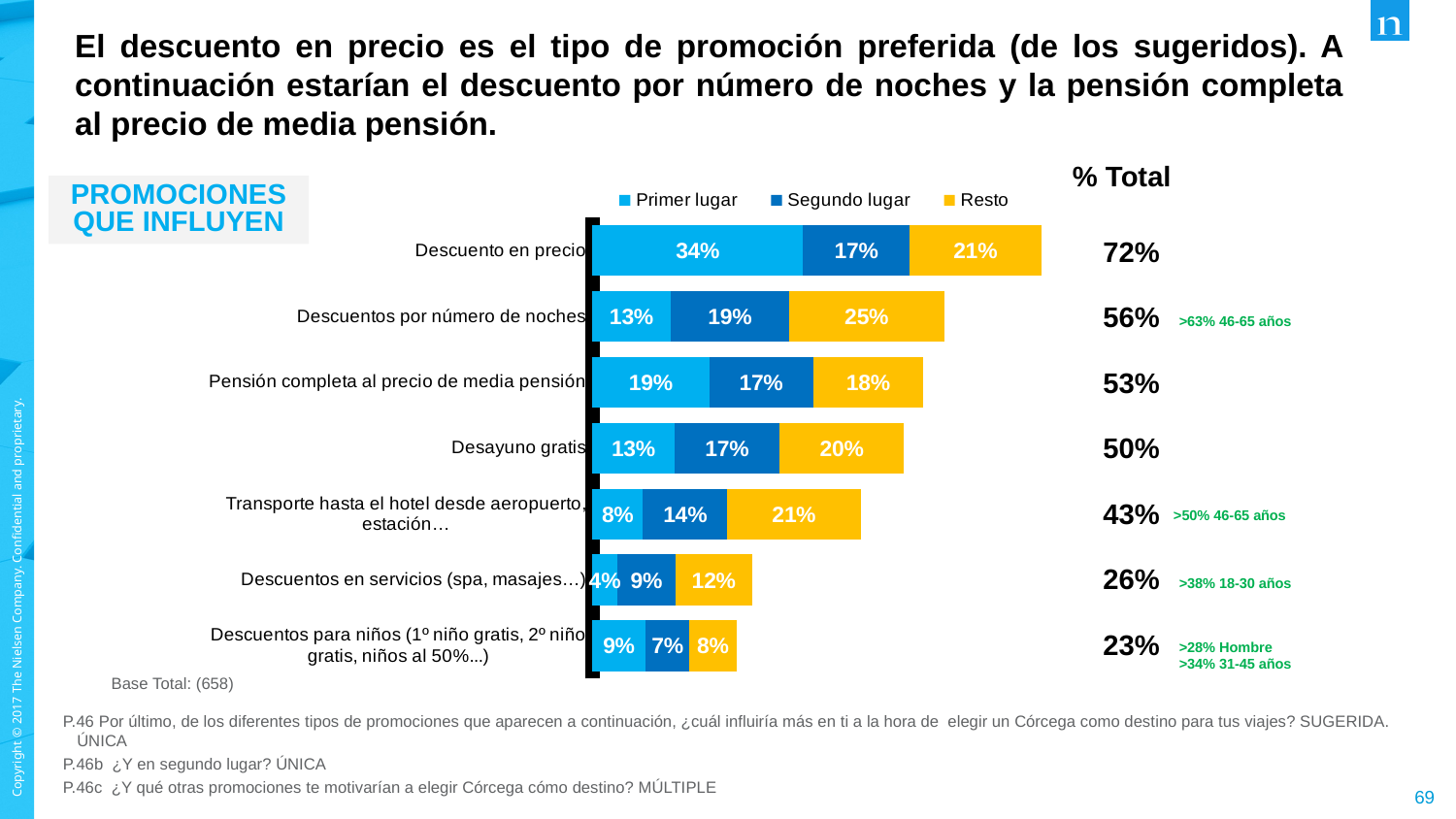
Which has the larger 'Segundo lugar' value: 'Descuentos por número de noches' or 'Desayuno gratis'? Descuentos por número de noches What are the three legend entries of the chart? Primer lugar, Segundo lugar, Resto What is the total of the stacked bar for 'Desayuno gratis'? 50% Which category has the lowest '% Total'? Descuentos para niños (1º niño gratis, 2º niño gratis, niños al 50%...) What is the 'Resto' value for 'Descuentos por número de noches'? 25% What kind of chart is shown on the slide? Bar chart What is the '% Total' shown for 'Transporte hasta el hotel desde aeropuerto, estación…'? 43% How many promotion categories are plotted in the chart? 7 How many series does the chart legend list? 3 Which category has the highest 'Primer lugar' value? Descuento en precio What is the 'Primer lugar' value for 'Descuento en precio'? 34% What is the difference between the 'Primer lugar' values for 'Descuento en precio' and 'Pensión completa al precio de media pensión'? 15 percentage points